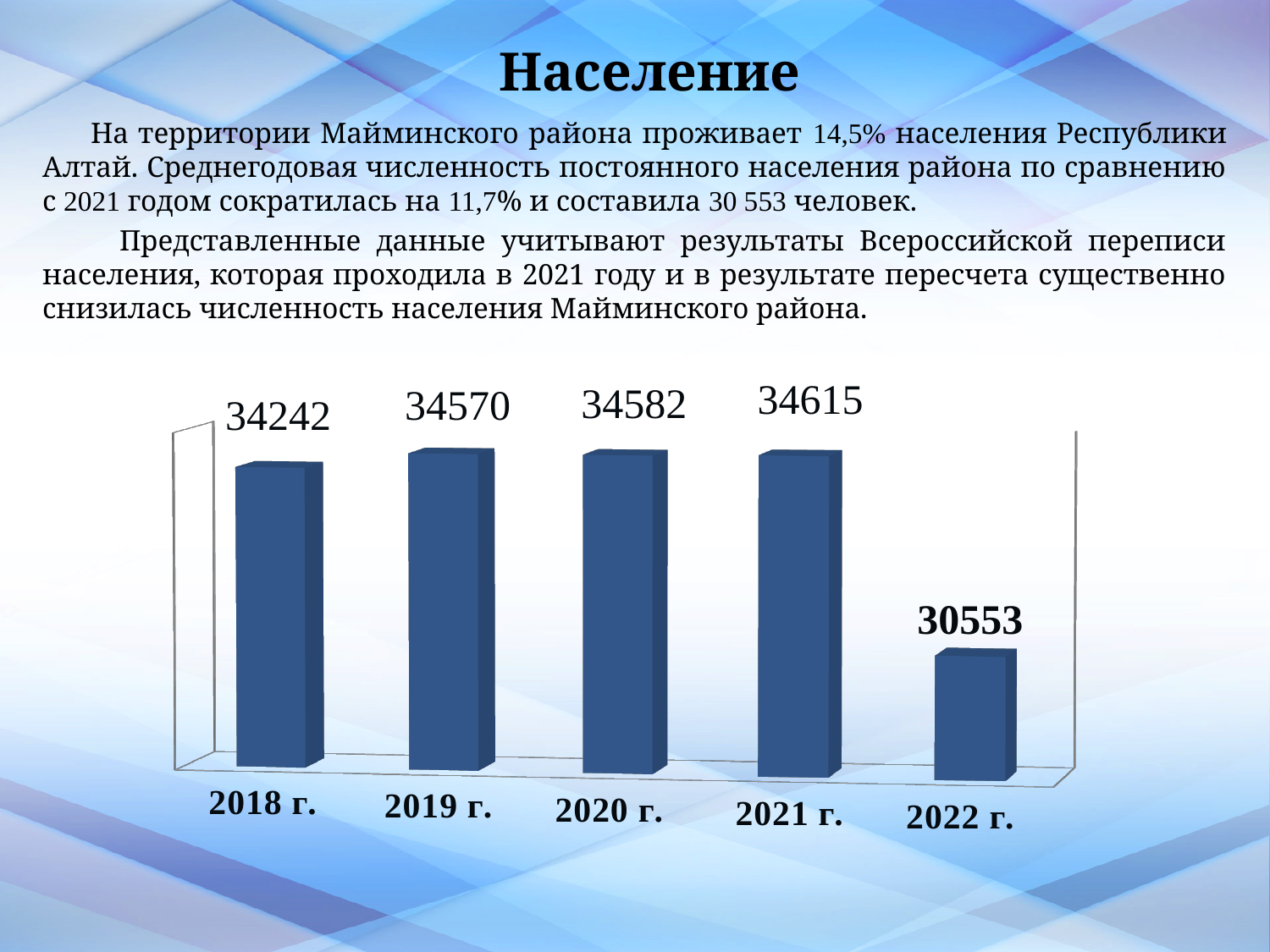
What is the value shown for 2020 г.? 34582 What is the title of the slide containing the chart? Население What is the difference between the values for 2019 г. and 2018 г.? 328 Which year has the lowest value in the chart? 2022 г. What is the difference between the values for 2021 г. and 2022 г.? 4062 What is the population value shown for 2018 г.? 34242 What is the population value shown for 2022 г.? 30553 Which year has the highest value in the chart? 2021 г. What kind of chart is shown on the slide? Bar chart Which is larger, the value for 2018 г. or the value for 2022 г.? 2018 г. How many years (categories) are shown in the chart? 5 Does the value rise or fall from 2021 г. to 2022 г.? Fall